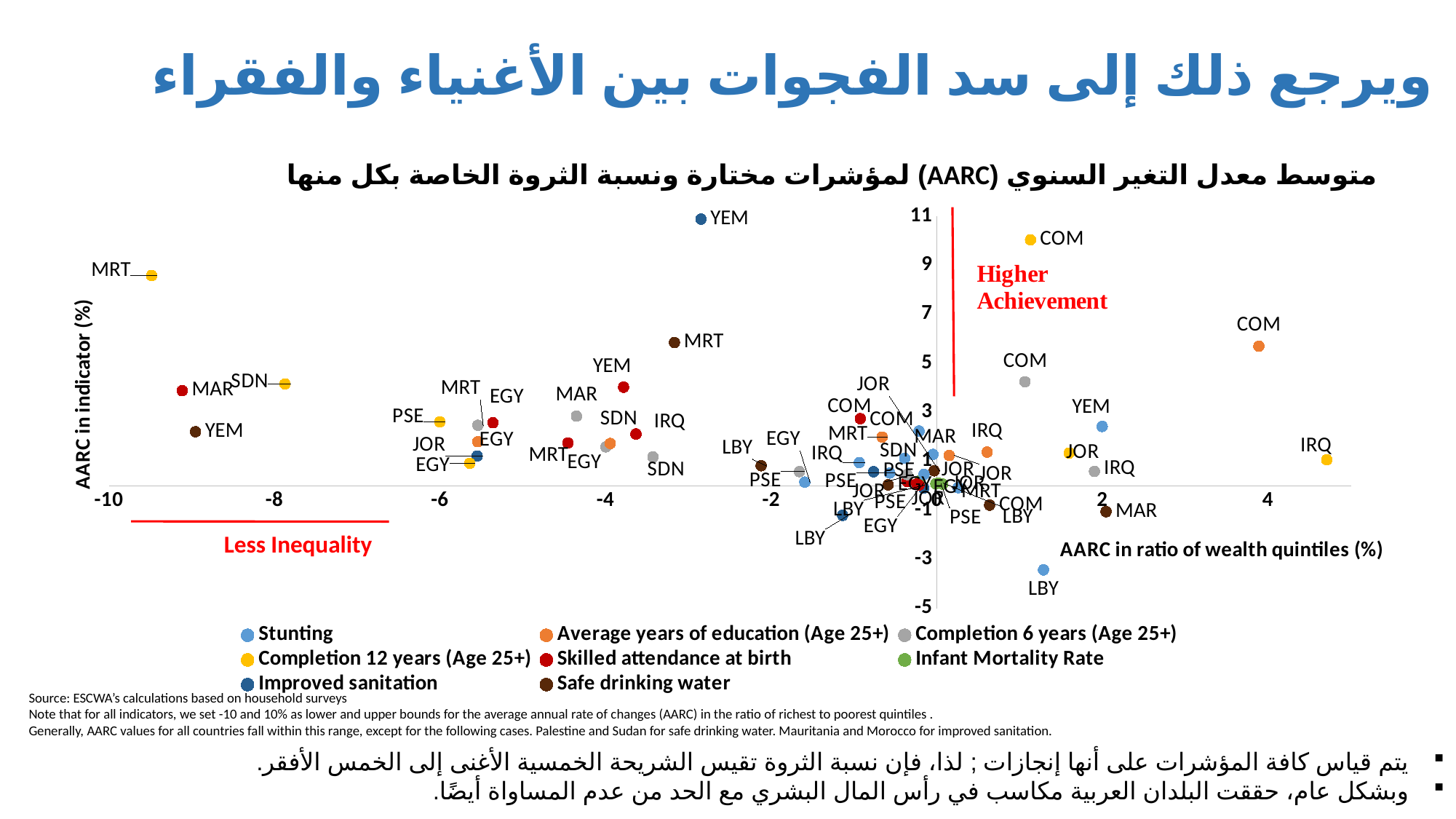
What is the title of the vertical axis of the chart? AARC in indicator (%) Which labelled point has the lowest AARC in indicator (%) on the chart? LBY (Stunting) Is the AARC in ratio of wealth quintiles (%) for the Completion 12 years point IRQ at the far right greater or less than 4? greater How many series does the chart legend list? 8 What is the title of the horizontal axis of the chart? AARC in ratio of wealth quintiles (%) What kind of chart is shown on the slide? scatter chart Is the AARC in indicator (%) for the Stunting point LBY at the bottom of the chart greater or less than -1? less Is the AARC in indicator (%) for the Improved sanitation point YEM at the top of the chart greater or less than 9? greater Which has the higher AARC in indicator (%): the Safe drinking water point MRT or the Skilled attendance at birth point YEM? MRT (Safe drinking water) Which labelled point has the highest AARC in indicator (%) on the chart? YEM (Improved sanitation) Which labelled point lies furthest to the left on the horizontal axis? MRT (Completion 12 years)